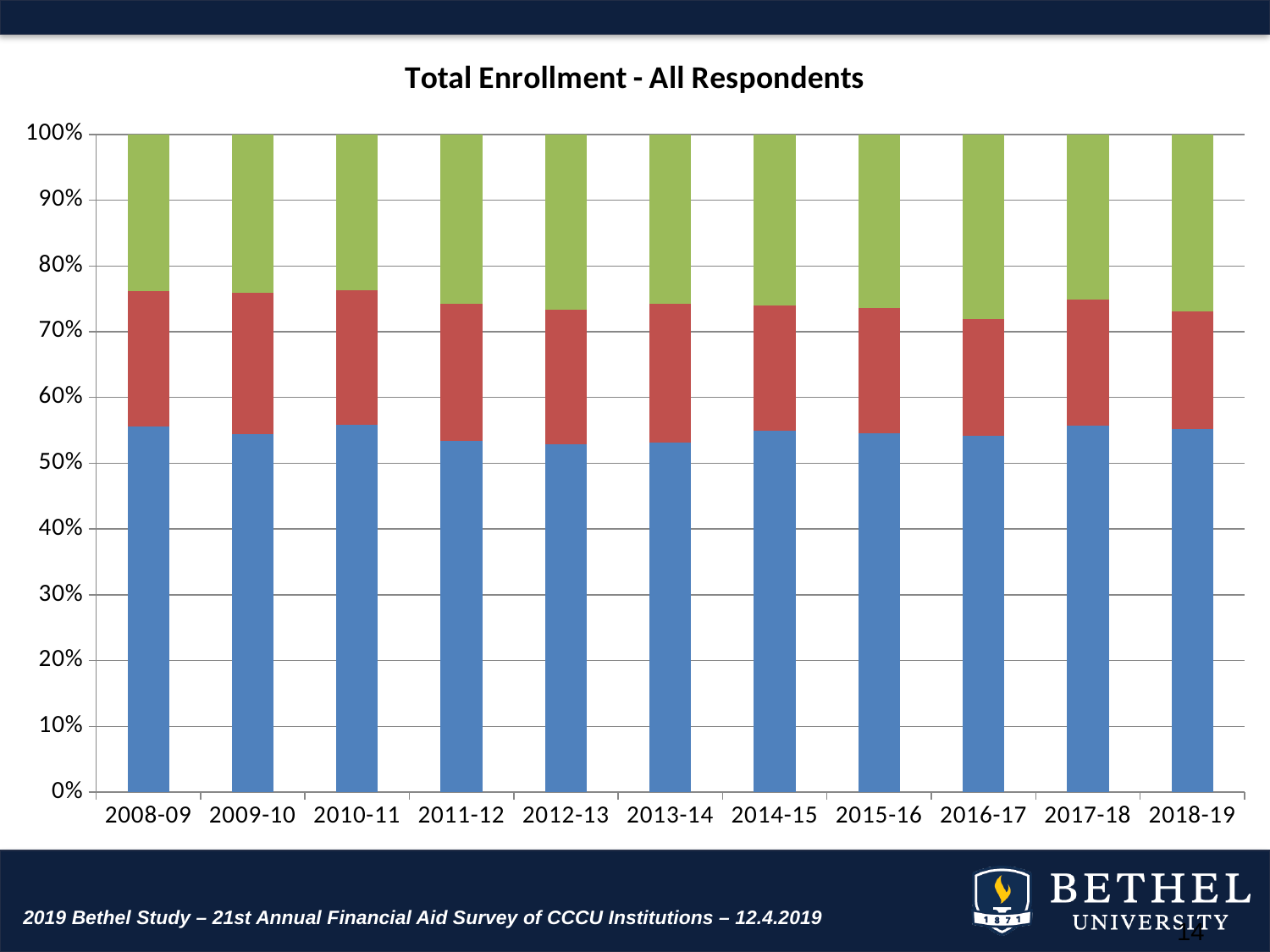
What is the total height of the stacked bar for 2018-19? 100% Is the top of the blue segment for 2012-13 greater or less than 60%? less Is the top of the blue segment for 2017-18 greater or less than 50%? greater How many academic years are shown on the x axis of the chart? 11 Is the top of the red segment for 2010-11 greater or less than 70%? greater What is the total height of the stacked bar for 2008-09? 100% What is the title of the chart? Total Enrollment - All Respondents What is the first academic year shown on the x axis? 2008-09 How many coloured segments make up each bar in the chart? 3 What kind of chart is shown on the slide? stacked bar chart